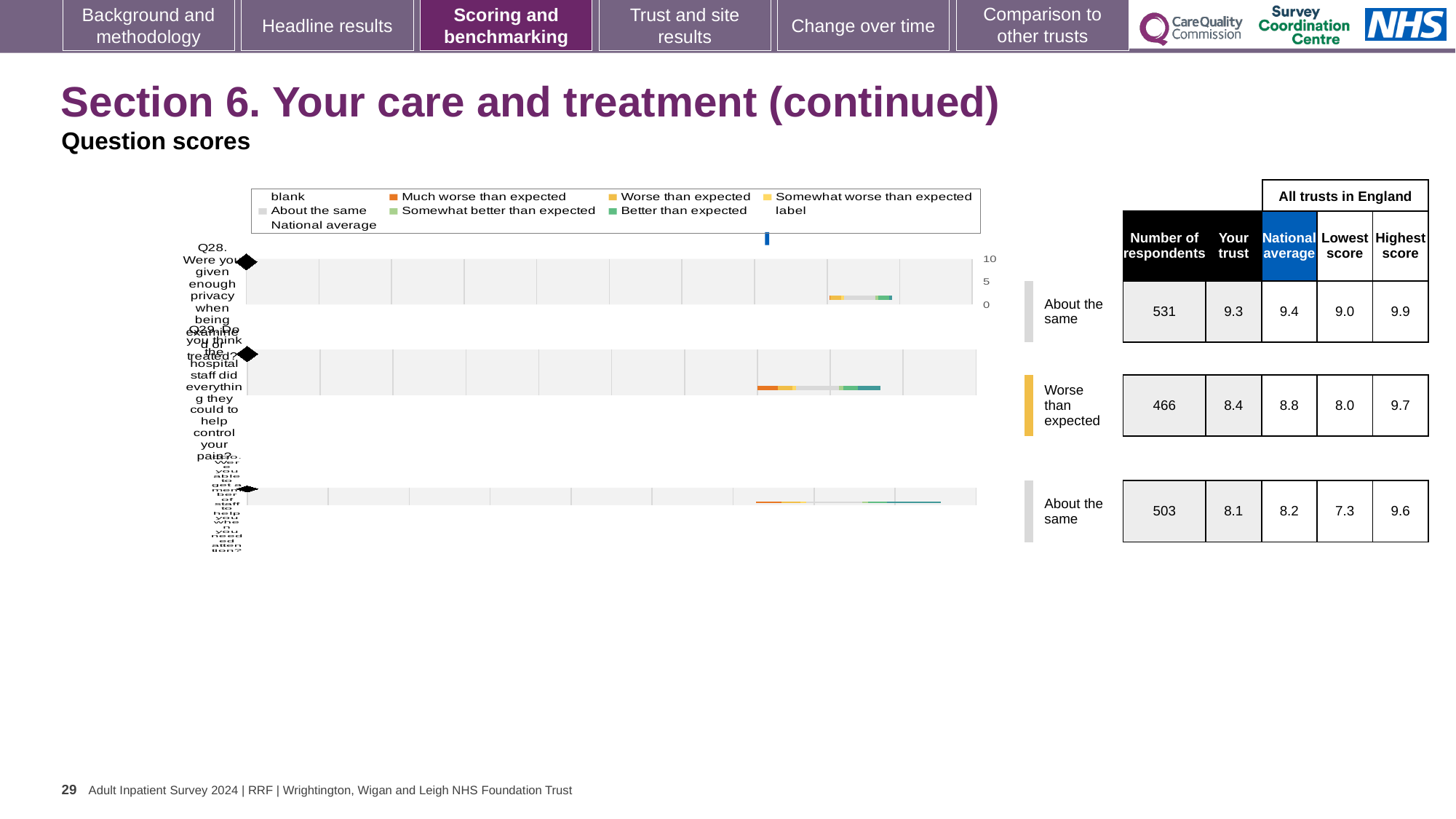
What is the lowest score among all trusts in England for Q28? 9.0 Which question has the highest 'Your trust' score? Q28 For Q29, which is larger: the 'Your trust' score or the national average? National average What is the 'Your trust' score for Q28 (privacy when being examined or treated)? 9.3 For Q29, what is the difference between the highest score and the lowest score among all trusts in England? 1.7 How many questions (rows) are plotted in the chart? 3 How many respondents answered Q30? 503 Which question has the lowest 'Your trust' score? Q30 What benchmark category is shown for Q29? Worse than expected For Q30, what is the difference between the highest score and the lowest score among all trusts in England? 2.3 What kind of chart is shown on the slide? bar chart What is the national average score for Q29 (hospital staff helping control pain)? 8.8